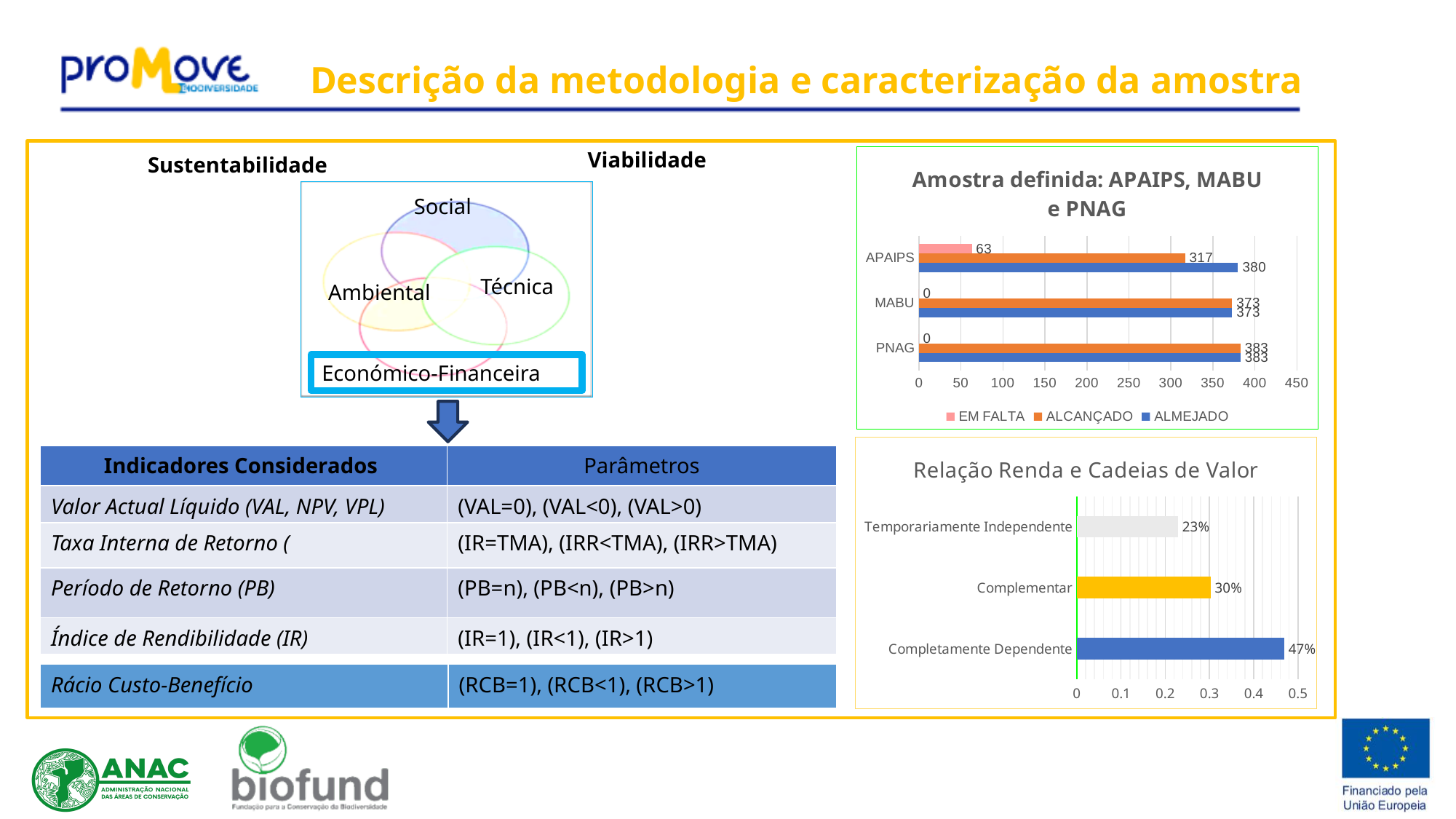
In the chart 'Amostra definida: APAIPS, MABU e PNAG', how many series does the legend list? 3 In the chart 'Relação Renda e Cadeias de Valor', which category has the lowest value? Temporariamente Independente In the chart 'Amostra definida: APAIPS, MABU e PNAG', what is the ALMEJADO value for PNAG? 383 In the chart 'Amostra definida: APAIPS, MABU e PNAG', what is the difference between the ALMEJADO and ALCANÇADO values for APAIPS? 63 In the chart 'Relação Renda e Cadeias de Valor', what is the difference between Completamente Dependente and Temporariamente Independente? 24% In the chart 'Amostra definida: APAIPS, MABU e PNAG', which category has the highest ALMEJADO value? PNAG In the chart 'Relação Renda e Cadeias de Valor', what is the value for Complementar? 30% In the chart 'Amostra definida: APAIPS, MABU e PNAG', what is the EM FALTA value for MABU? 0 What kind of chart is 'Relação Renda e Cadeias de Valor'? Bar chart In the chart 'Amostra definida: APAIPS, MABU e PNAG', what is the EM FALTA value for APAIPS? 63 In the chart 'Amostra definida: APAIPS, MABU e PNAG', what is the ALCANÇADO value for APAIPS? 317 In the chart 'Relação Renda e Cadeias de Valor', which category has the highest value? Completamente Dependente